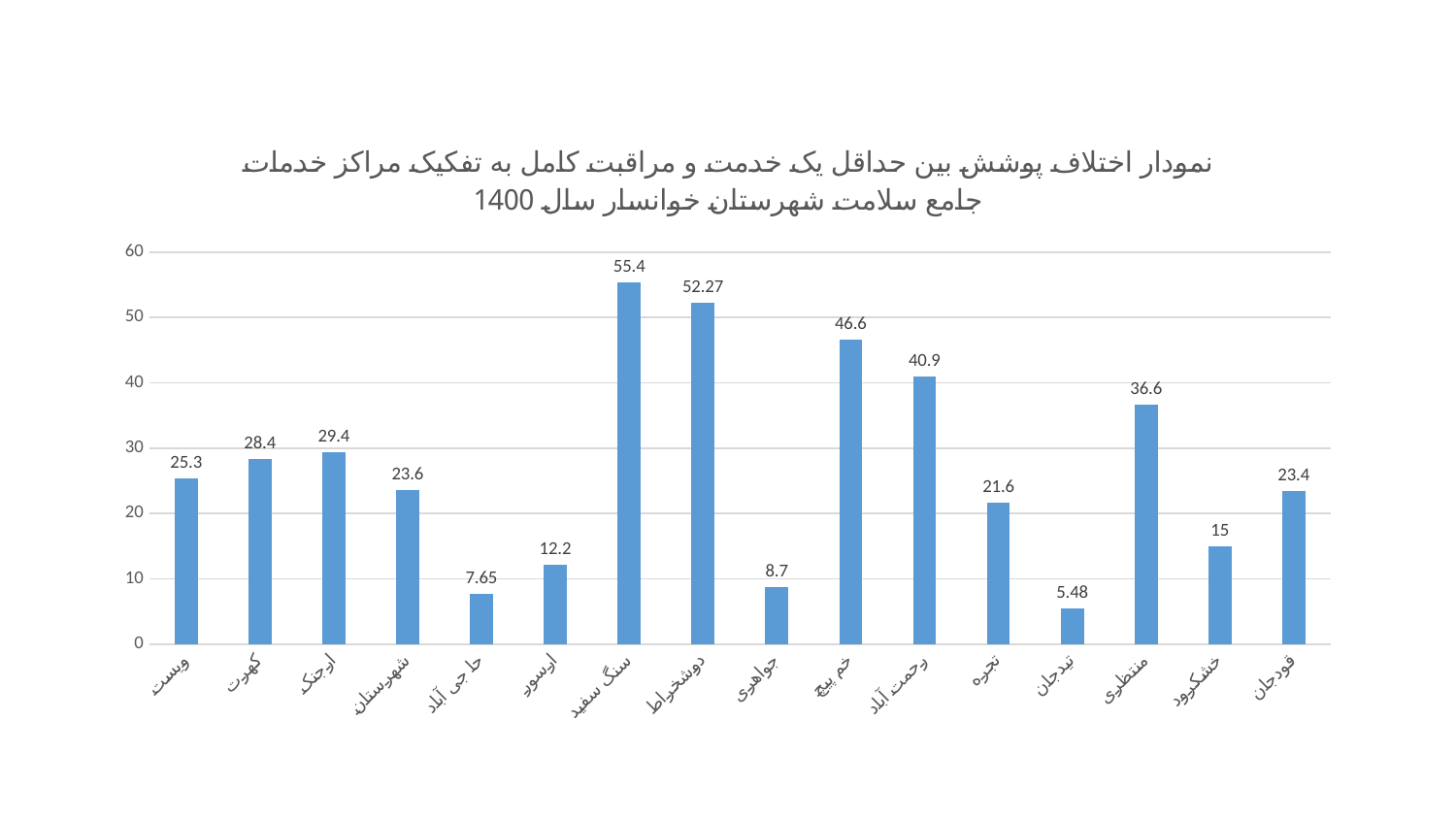
What is the difference between the values for سنگ سفید and دوشخراط? 3.13 Which is larger, the value for منتظری or the value for تجره? منتظری What is the difference between the values for خم پیچ and رحمت آباد? 5.7 Is the value for رحمت آباد greater or less than 40? greater Which category has the lowest value? تیدجان What is the value for سنگ سفید? 55.4 What is the value for حاجی آباد? 7.65 How many categories are shown on the x axis? 16 Which category has the highest value? سنگ سفید What year is mentioned in the chart title? 1400 What kind of chart is shown on the slide? bar chart What is the value for خشکرود? 15